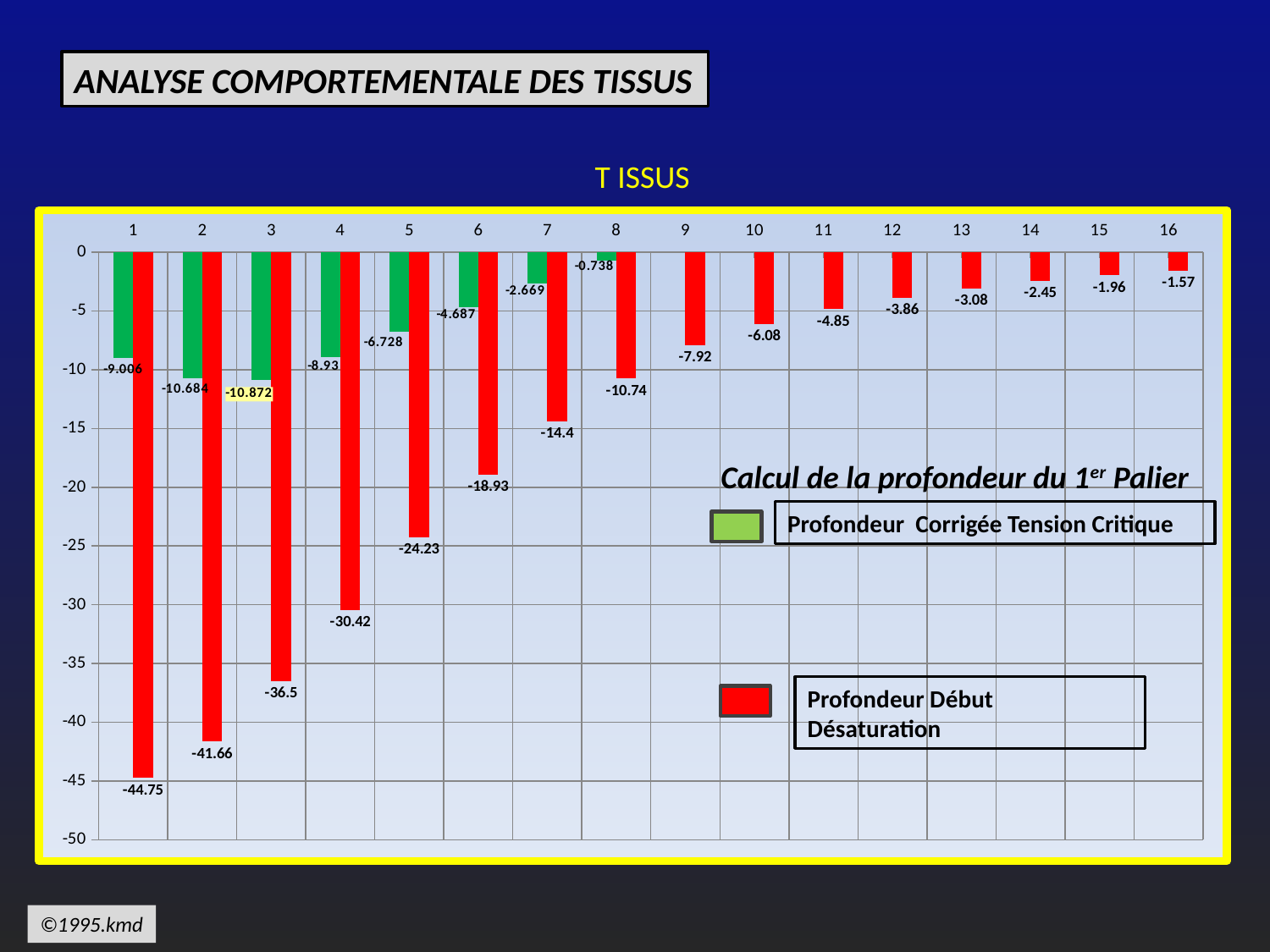
Which tissue has the most negative Profondeur Début Désaturation value? 1 Which tissue has the Profondeur Corrigée Tension Critique value closest to zero? 8 What colour represents Profondeur Début Désaturation in the legend? red What is the difference between the Profondeur Début Désaturation values for tissue 1 and tissue 2? 3.09 Which has the more negative Profondeur Début Désaturation value, tissue 5 or tissue 6? tissue 5 What is the Profondeur Début Désaturation value for tissue 8? -10.74 Do the Profondeur Début Désaturation values become more or less negative from tissue 1 to tissue 16? less negative What is the Profondeur Début Désaturation value for tissue 1? -44.75 How many tissue categories are shown on the x axis? 16 What is the Profondeur Corrigée Tension Critique value for tissue 3? -10.872 What kind of chart is shown on the slide? bar chart How many series does the legend list? 2